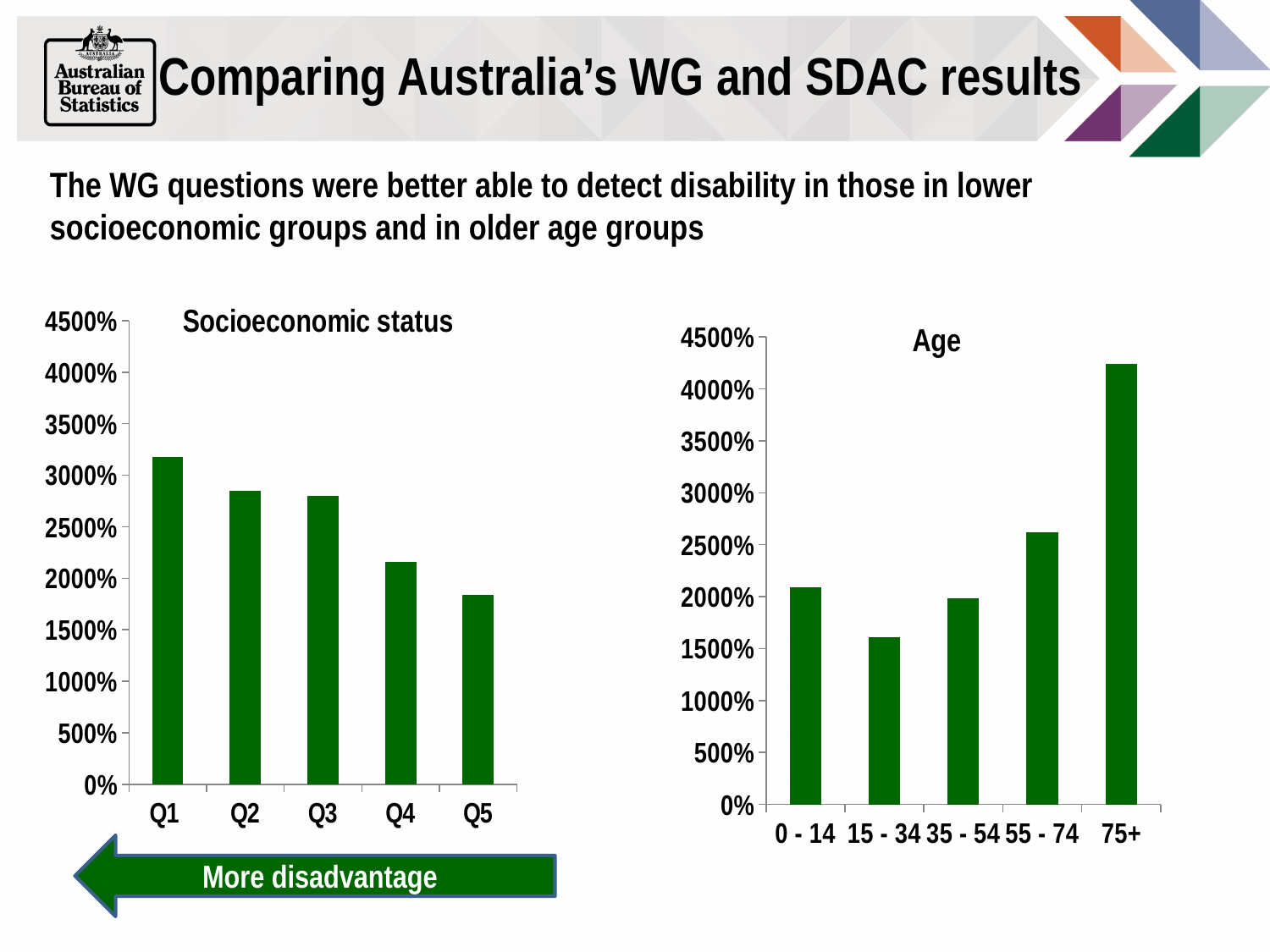
How many categories are shown in the Socioeconomic status chart? 5 In the Socioeconomic status chart, which category has the highest value? Q1 In the Socioeconomic status chart, which is larger, the value for Q1 or the value for Q4? Q1 In the Socioeconomic status chart, do the values generally rise or fall from Q1 to Q5? fall What kind of chart is the Age chart? bar chart In the Age chart, which age group has the lowest value? 15 - 34 In the Socioeconomic status chart, which category has the lowest value? Q5 In the Socioeconomic status chart, is the value for Q1 greater or less than 3000%? greater In the Age chart, is the value for 15 - 34 greater or less than 2000%? less In the Age chart, is the value for 75+ greater or less than 4000%? greater In the Age chart, which age group has the highest value? 75+